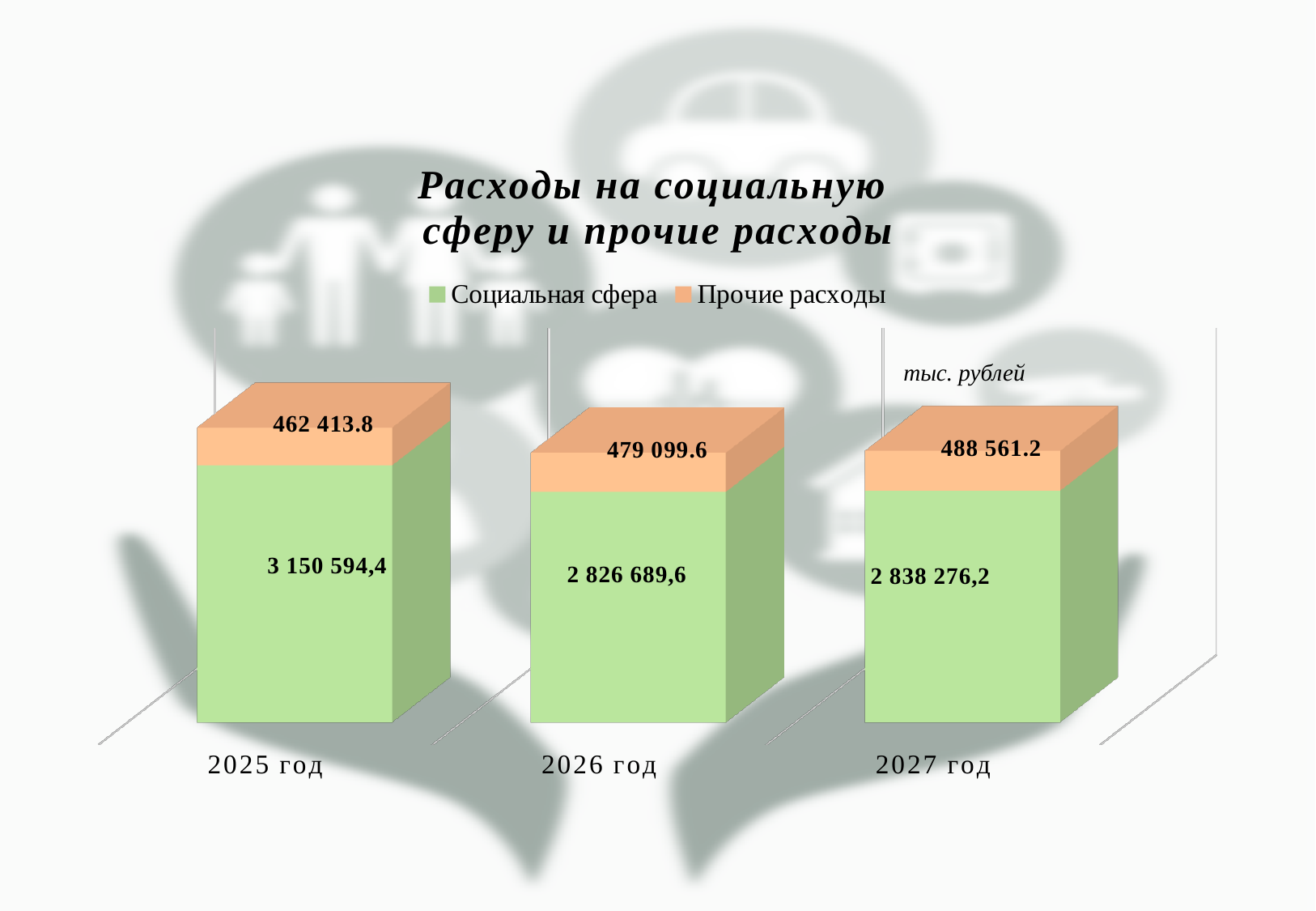
What is the value of Социальная сфера for 2025 год? 3 150 594,4 In which year is Прочие расходы the lowest? 2025 год What is the difference between Прочие расходы in 2027 год and in 2025 год? 26 147.4 What is the value of Прочие расходы for 2027 год? 488 561.2 How many categories (years) are shown on the x axis? 3 What kind of chart is shown on the slide? Stacked bar chart What is the value of Прочие расходы for 2026 год? 479 099.6 What is the title of the chart? Расходы на социальную сферу и прочие расходы In which year is Социальная сфера the highest? 2025 год Do the values of Прочие расходы rise or fall from 2025 год to 2027 год? Rise How many series does the legend list? 2 Which is larger, Социальная сфера in 2026 год or in 2027 год? 2027 год